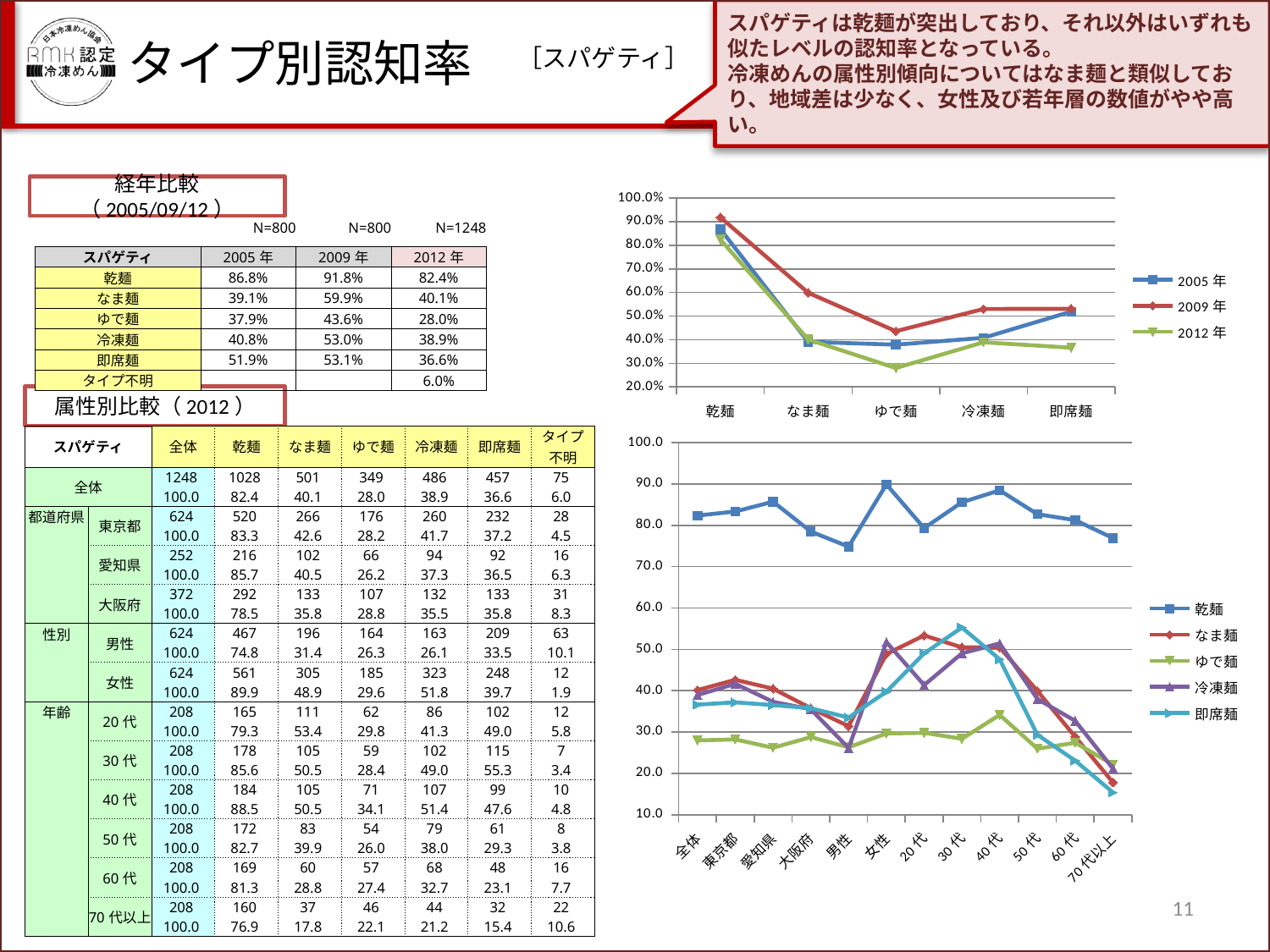
In the top chart (経年比較), which is larger for 冷凍麺: the 2005年 value or the 2009年 value? 2009年 In the top chart (経年比較), what is the 2009年 value for なま麺? 59.9% How many categories are shown on the x axis of the top chart (経年比較)? 5 What kind of chart is the top chart (経年比較) on the slide? line chart How many series does the legend of the top chart (経年比較) list? 3 In the bottom chart (属性別比較 2012), which category has the highest value for 乾麺? 女性 How many categories are shown on the x axis of the bottom chart (属性別比較 2012)? 12 In the top chart (経年比較), is the 2009年 value for 乾麺 greater or less than 90%? greater How many series does the legend of the bottom chart (属性別比較 2012) list? 5 In the bottom chart (属性別比較 2012), what is the difference between the 乾麺 values for 女性 and 男性? 15.1 In the top chart (経年比較), which category has the highest 2012年 value? 乾麺 In the top chart (経年比較), which category has the lowest 2012年 value? ゆで麺